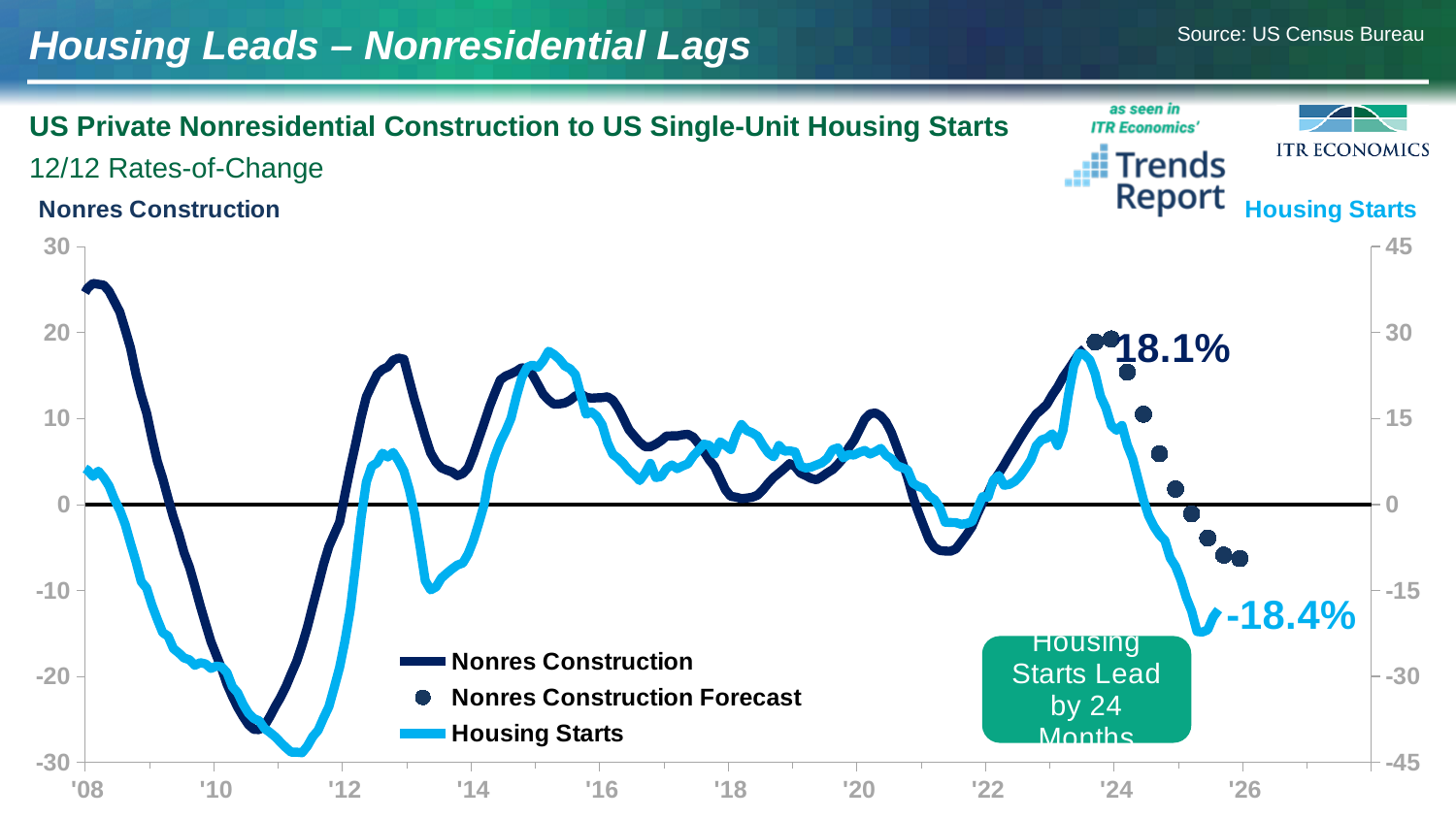
What is the labeled value for Housing Starts near 2025? -18.4% Which series has the larger labeled value, Nonres Construction at 18.1% or Housing Starts at -18.4%? Nonres Construction Does the Housing Starts line rise or fall between 2024 and 2025? Fall What kind of chart is shown on the slide? Line chart What is the title of the chart? US Private Nonresidential Construction to US Single-Unit Housing Starts What is the labeled peak value for Nonres Construction near 2024? 18.1% Does the Nonres Construction Forecast (dotted) rise or fall from 2024 to 2026? Fall Is the Nonres Construction value at the start of 2008 greater or less than 20 on the left axis? greater According to the callout box, by how many months do Housing Starts lead? 24 months What is the difference between the labeled Nonres Construction value (18.1%) and the labeled Housing Starts value (-18.4%)? 36.5 percentage points How many series does the legend list? 3